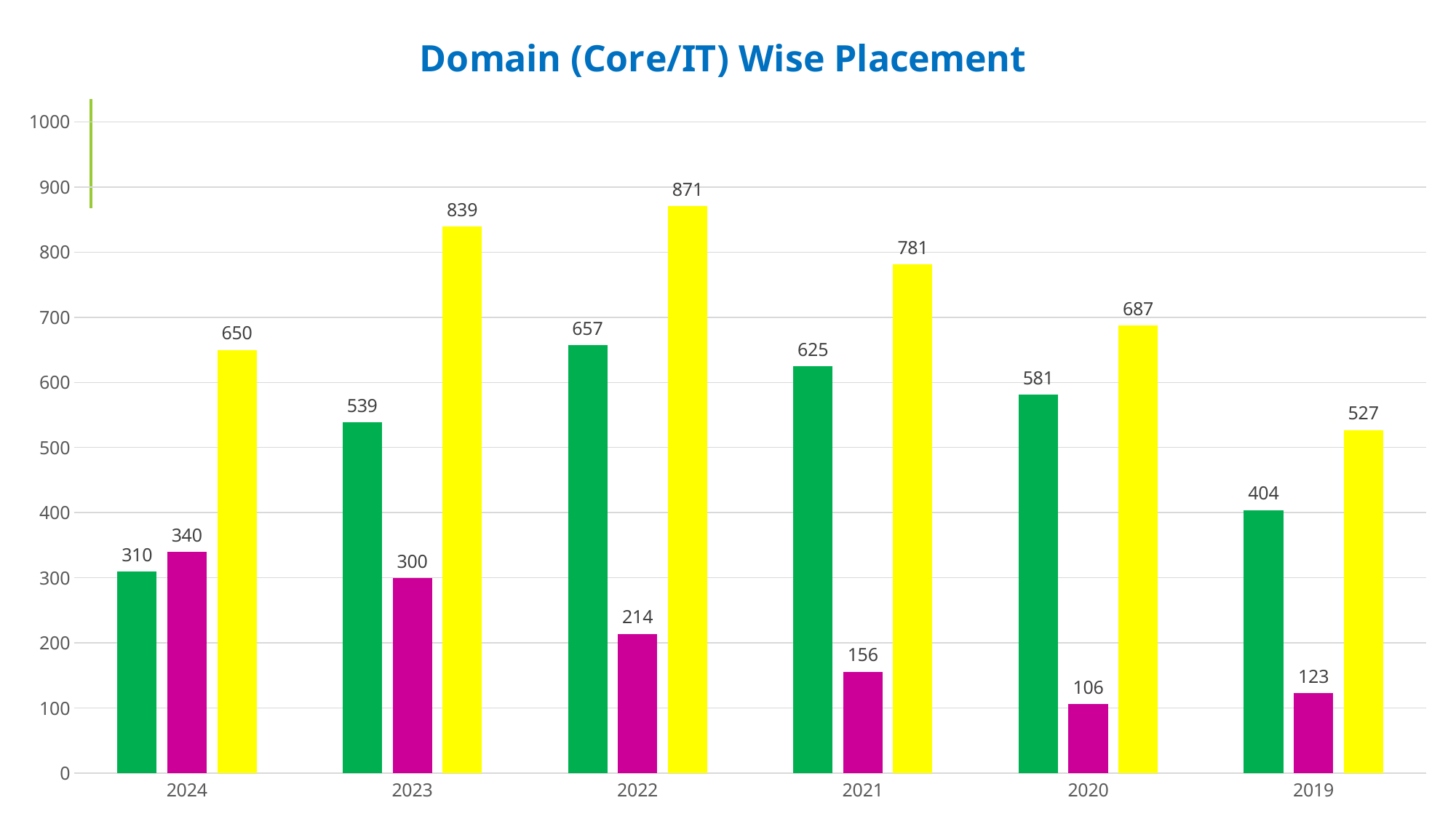
What is the value of the green bar for 2021? 625 What kind of chart is shown on the slide? bar chart Which year has the lowest green bar? 2024 What is the title of the chart? Domain (Core/IT) Wise Placement Which year has the highest yellow bar? 2022 How many years are shown on the x axis? 6 What is the difference between the yellow bar and the green bar for 2023? 300 What is the total of the three bars for 2019? 1054 Which is larger for 2024, the green bar or the magenta bar? the magenta bar What is the value of the yellow bar for 2022? 871 What is the value of the magenta bar for 2020? 106 Which year has the lowest magenta bar? 2020